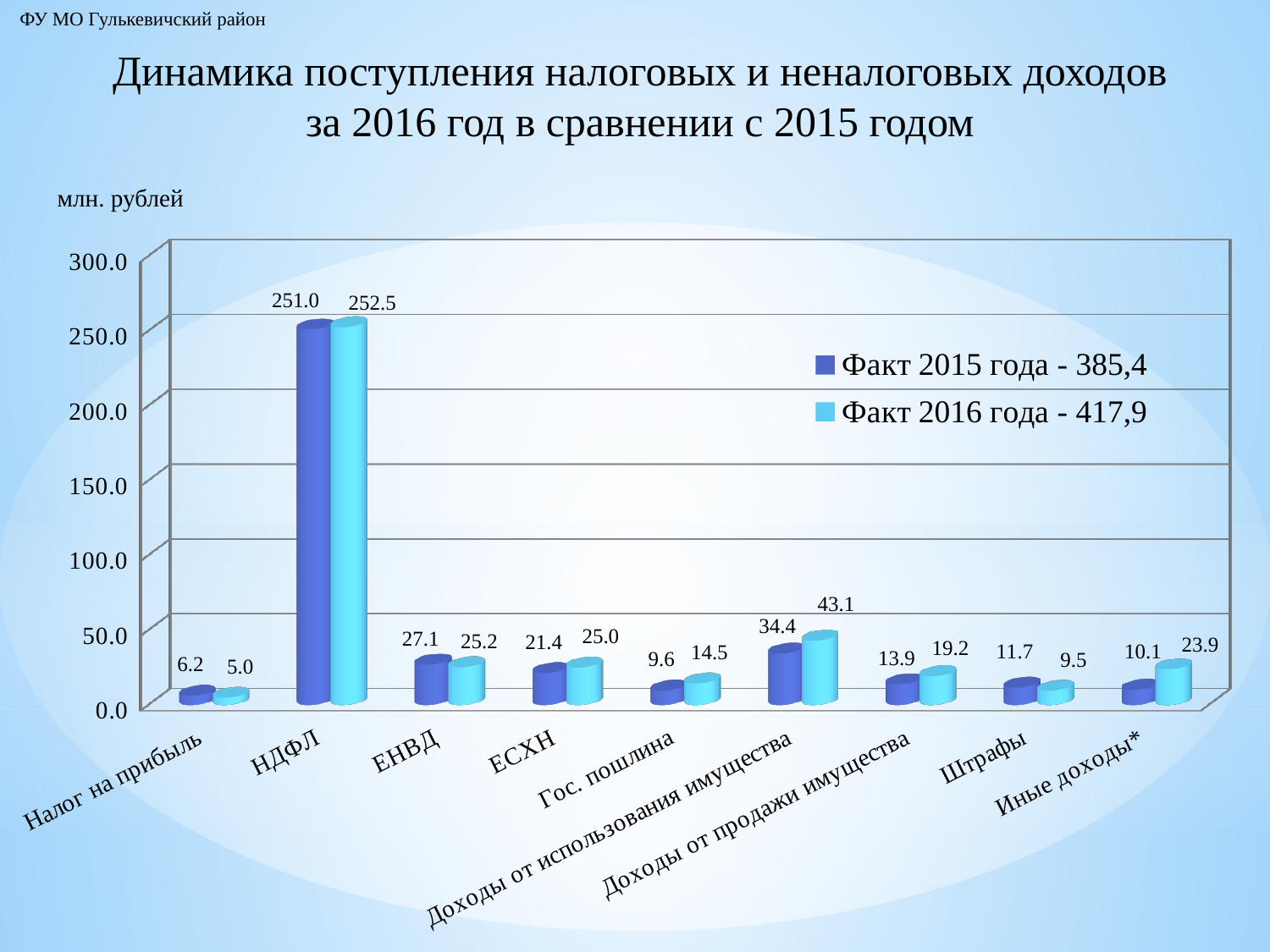
Which category has the lowest value in the series Факт 2016 года? Налог на прибыль For Штрафы, which series has the larger value: Факт 2015 года or Факт 2016 года? Факт 2015 года What is the difference between the Факт 2016 года and Факт 2015 года values for Доходы от использования имущества? 8.7 How many categories are shown on the x axis? 9 What is the value for Гос. пошлина in the series Факт 2015 года? 9.6 What is the value for НДФЛ in the series Факт 2016 года? 252.5 Which category has the highest value in the series Факт 2015 года? НДФЛ How many series does the legend list? 2 What unit of measurement is indicated above the chart? млн. рублей What kind of chart is shown on the slide? Bar chart What total is given in the legend entry for Факт 2016 года? 417,9 What is the value for Иные доходы* in the series Факт 2016 года? 23.9